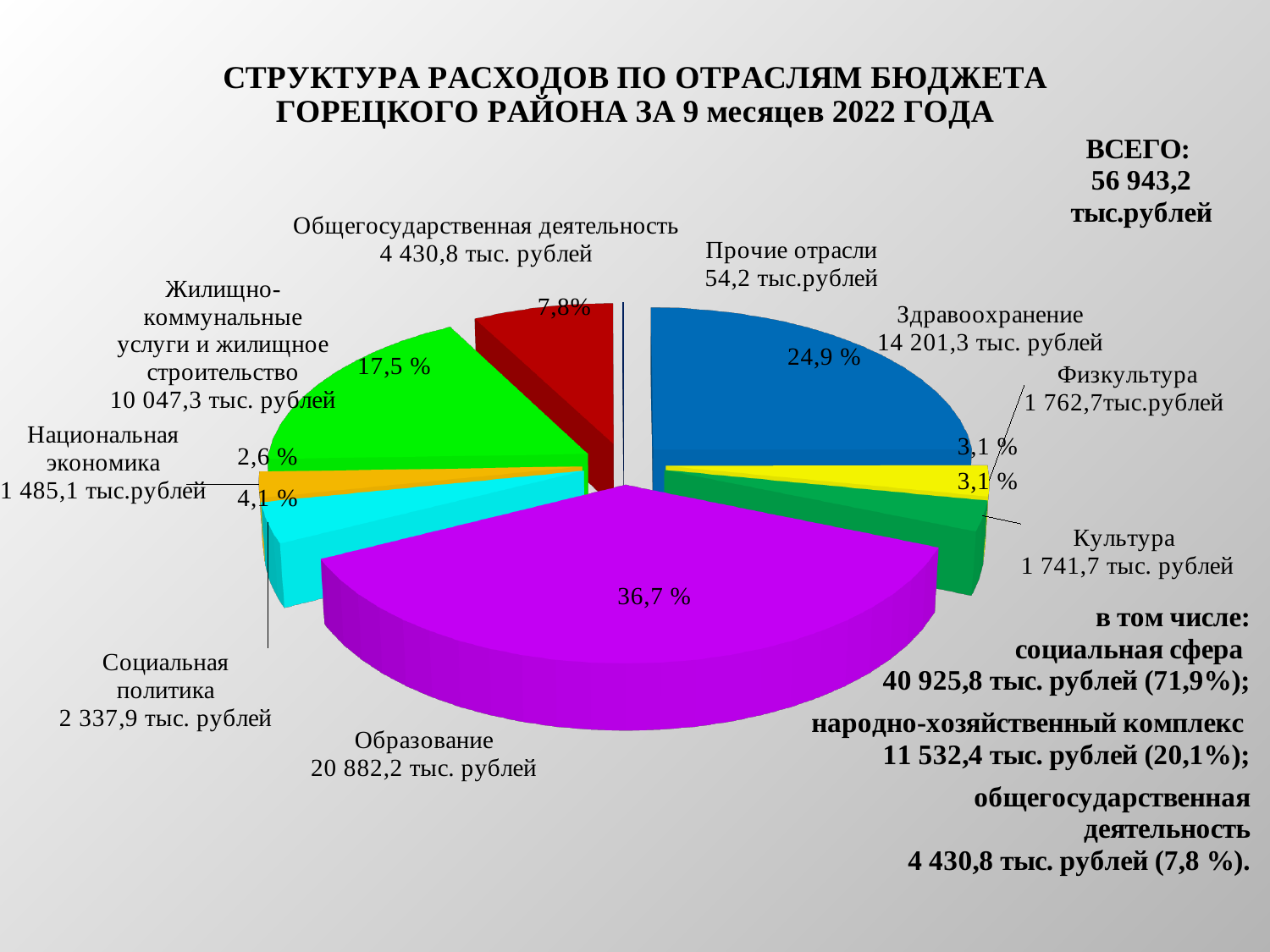
Which is larger, Здравоохранение or Жилищно-коммунальные услуги и жилищное строительство? Здравоохранение What share of the pie does Образование take? 36,7 % What is the difference between the values for Общегосударственная деятельность and Социальная политика? 2 092,9 тыс. рублей What is the value for Жилищно-коммунальные услуги и жилищное строительство? 10 047,3 тыс. рублей What is the value for Образование? 20 882,2 тыс. рублей What kind of chart is shown on the slide? Pie chart What share of the pie does Здравоохранение take? 24,9 % How many categories are shown in the pie chart? 9 Which category has the largest share of the pie? Образование What is the value for Прочие отрасли? 54,2 тыс.рублей Which category has the smallest share of the pie? Прочие отрасли What is the value for Здравоохранение? 14 201,3 тыс. рублей